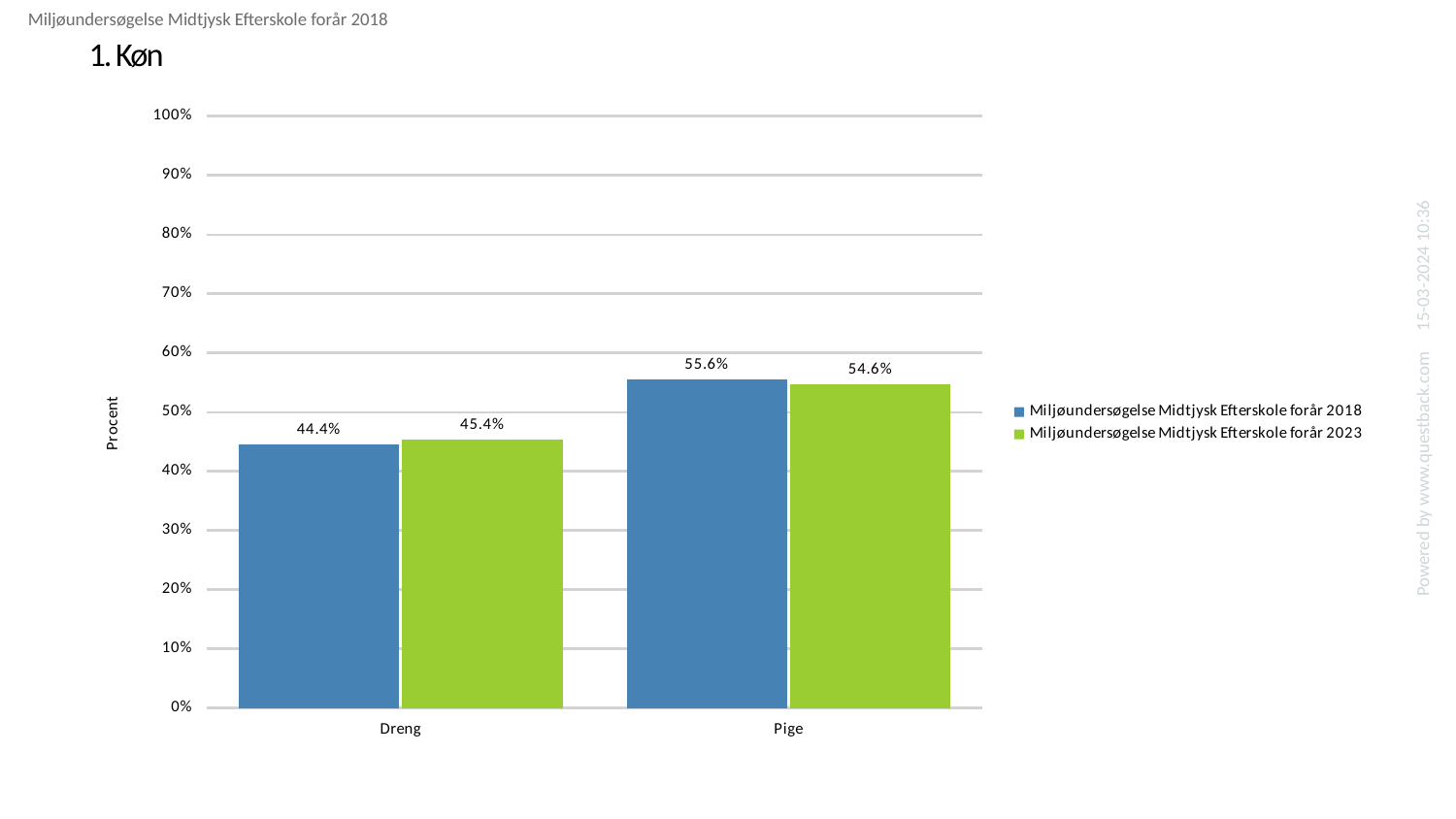
What is the difference between the 2018 and 2023 values for Pige? 1.0% How many series does the legend list? 2 How many categories are shown on the x axis? 2 What is the difference between the Pige and Dreng values in the Miljøundersøgelse Midtjysk Efterskole forår 2018 series? 11.2% What is the value for Dreng in the Miljøundersøgelse Midtjysk Efterskole forår 2018 series? 44.4% Which category has the highest value in the Miljøundersøgelse Midtjysk Efterskole forår 2018 series? Pige Which category has the lowest value in the Miljøundersøgelse Midtjysk Efterskole forår 2023 series? Dreng What is the value for Pige in the Miljøundersøgelse Midtjysk Efterskole forår 2018 series? 55.6% What is the value for Dreng in the Miljøundersøgelse Midtjysk Efterskole forår 2023 series? 45.4% What is the value for Pige in the Miljøundersøgelse Midtjysk Efterskole forår 2023 series? 54.6% What kind of chart is shown on the slide? Bar chart Is the value for Pige in the 2018 series greater or less than 50%? greater